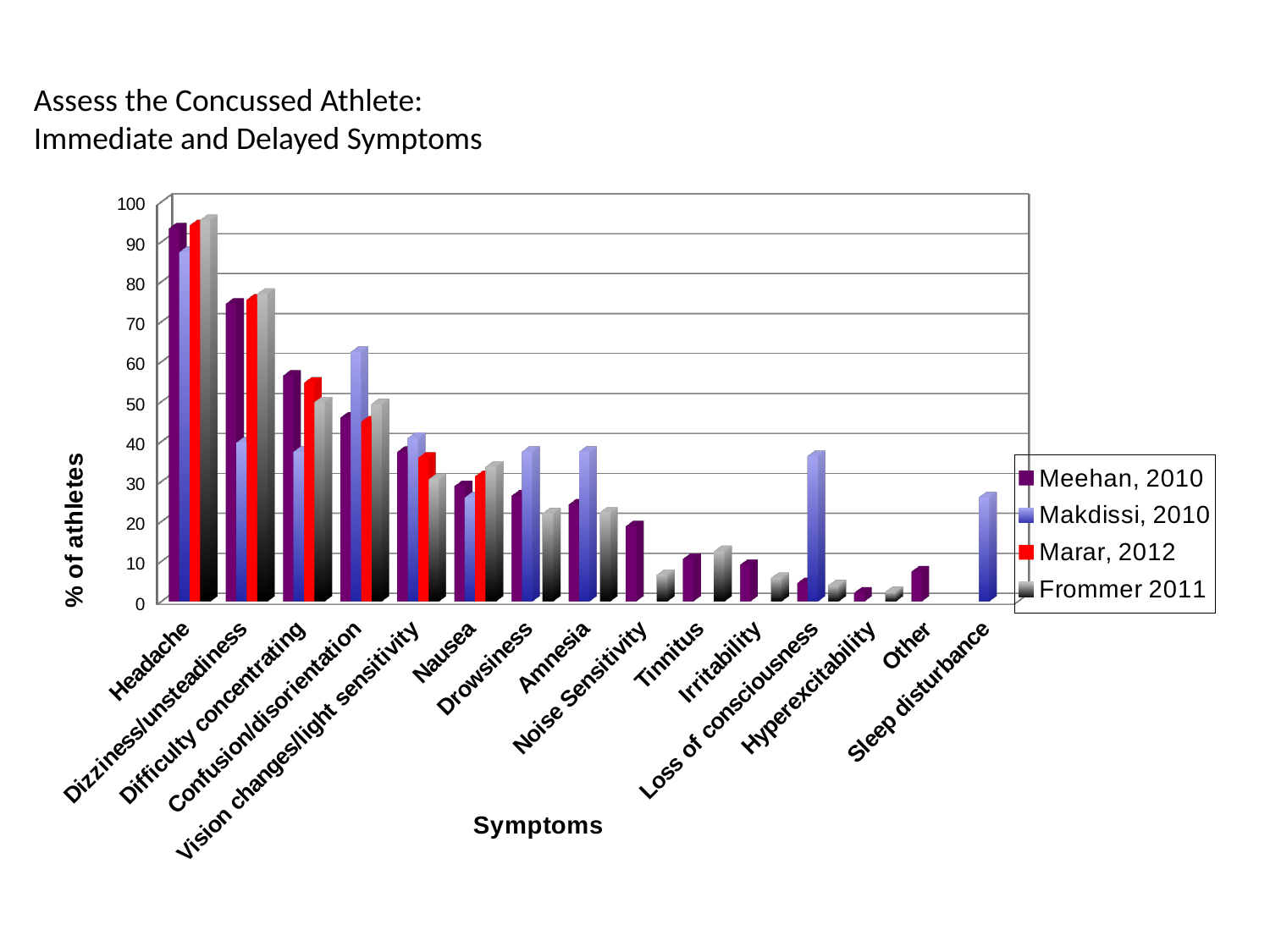
What kind of chart is shown on the slide? bar chart Is the Makdissi, 2010 value for Dizziness/unsteadiness greater or less than 50? less How many series does the legend list? 4 Is the Makdissi, 2010 value for Loss of consciousness greater or less than 30? greater For Dizziness/unsteadiness, which is larger: the Meehan, 2010 value or the Makdissi, 2010 value? Meehan, 2010 Is the Meehan, 2010 value for Noise Sensitivity greater or less than 30? less How many symptom categories are shown on the x axis? 15 Which symptom has the highest value for the Meehan, 2010 series? Headache What is the title of the vertical axis? % of athletes For Confusion/disorientation, which series has the highest value? Makdissi, 2010 Which series is the only one with a bar for Sleep disturbance? Makdissi, 2010